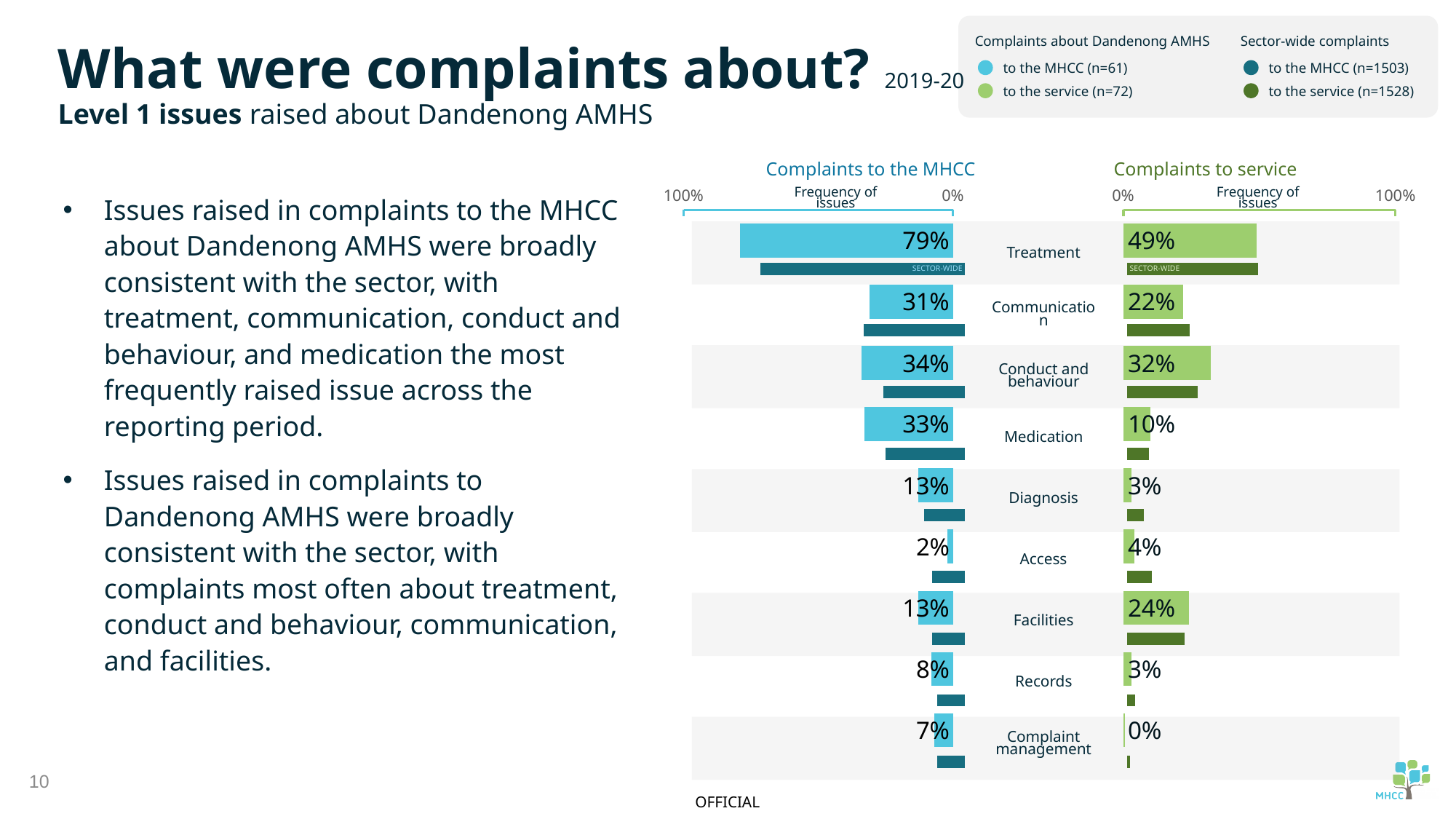
In the Complaints to the MHCC chart, which issue has the lowest frequency? Access In the Complaints to service chart, which issue has the lowest frequency? Complaint management In the Complaints to service chart, what is the value for Conduct and behaviour? 32% What is the difference between the Treatment values in the Complaints to the MHCC chart and the Complaints to service chart? 30 percentage points In the Complaints to the MHCC chart, which is larger: the value for Medication or the value for Communication? Medication In the Complaints to service chart, what is the value for Facilities? 24% In the Complaints to the MHCC chart, what percentage of complaints raised Treatment as an issue? 79% How many series does the legend at the top right list? 4 How many issue categories are shown in the charts? 9 What type of chart is used to show the frequency of issues? Bar chart In the Complaints to the MHCC chart, which issue has the highest frequency? Treatment According to the legend, how many complaints about Dandenong AMHS were made to the MHCC? n=61